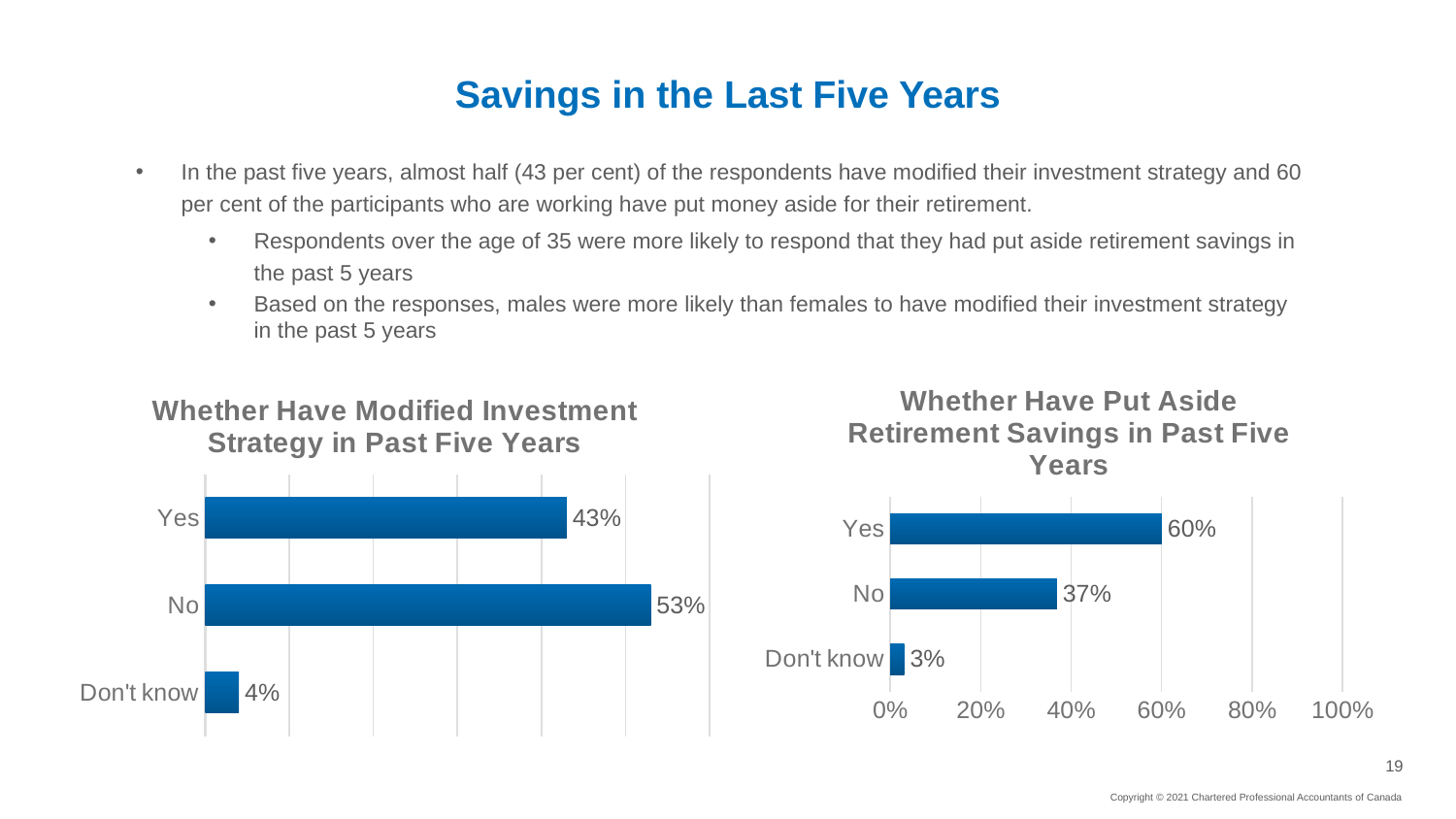
In the 'Whether Have Put Aside Retirement Savings in Past Five Years' chart, which category has the lowest value? Don't know In the 'Whether Have Put Aside Retirement Savings in Past Five Years' chart, what is the value for No? 37% In the 'Whether Have Modified Investment Strategy in Past Five Years' chart, what is the value for Yes? 43% How many categories does the 'Whether Have Modified Investment Strategy in Past Five Years' chart show? 3 In the 'Whether Have Put Aside Retirement Savings in Past Five Years' chart, what is the value for Don't know? 3% In the 'Whether Have Modified Investment Strategy in Past Five Years' chart, which category has the highest value? No In the 'Whether Have Modified Investment Strategy in Past Five Years' chart, what is the difference between the No and Yes values? 10% In the 'Whether Have Put Aside Retirement Savings in Past Five Years' chart, is the value for No greater or less than 40%? less In the 'Whether Have Put Aside Retirement Savings in Past Five Years' chart, what is the difference between the Yes and No values? 23% In the 'Whether Have Modified Investment Strategy in Past Five Years' chart, what is the value for No? 53% In the 'Whether Have Put Aside Retirement Savings in Past Five Years' chart, which is larger, Yes or No? Yes What kind of chart is the 'Whether Have Put Aside Retirement Savings in Past Five Years' chart? Bar chart